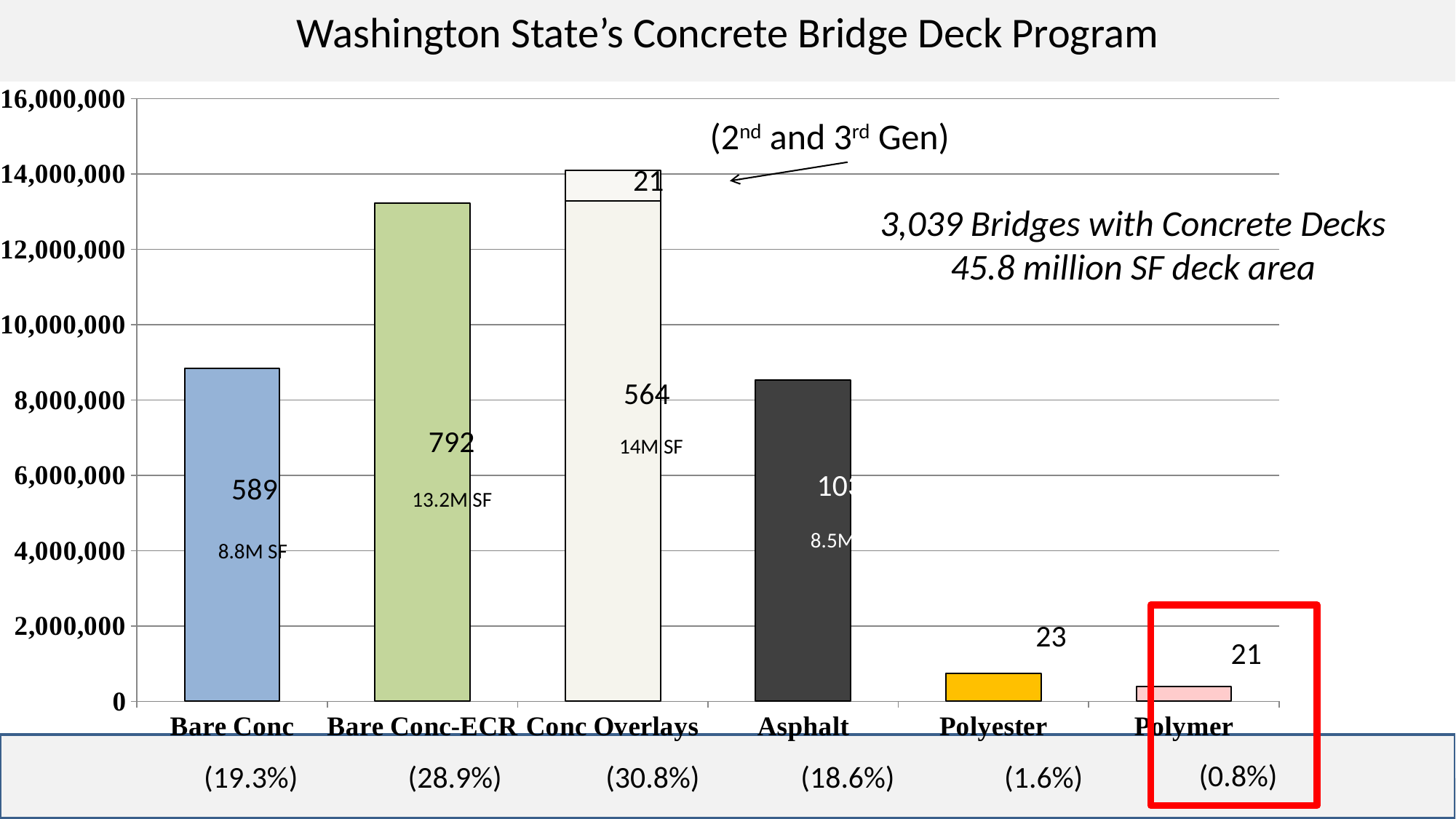
What number is printed on the Bare Conc bar? 589 Is the value for Bare Conc greater or less than 8,000,000? greater What number is printed above the Polyester bar? 23 What deck area label is printed on the Bare Conc-ECR bar? 13.2M SF What percentage is shown below the Conc Overlays category? (30.8%) How many categories are shown on the x axis of the chart? 6 Is the value for Polyester greater or less than 2,000,000? less What number is printed on the Bare Conc-ECR bar? 792 Which category has the shortest bar in the chart? Polymer What kind of chart is shown on the slide? bar chart Which category has the tallest bar in the chart? Conc Overlays What is the title of the chart? Washington State's Concrete Bridge Deck Program